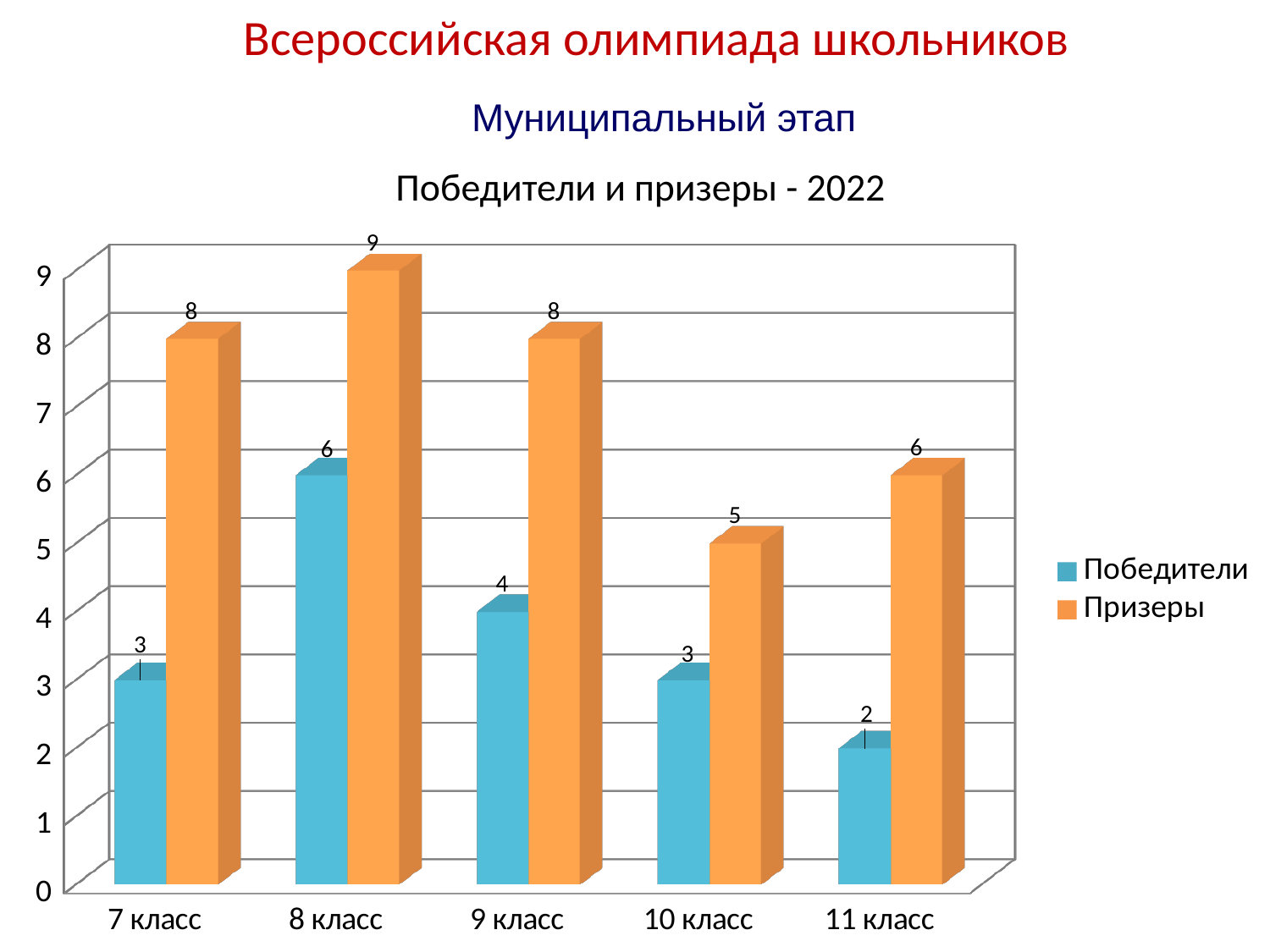
What is the value for Призеры in 10 класс? 5 Which class has the highest value for Призеры? 8 класс What is the difference between Призеры and Победители in 7 класс? 5 What is the title of the chart? Победители и призеры - 2022 Which is larger in 9 класс: Победители or Призеры? Призеры What is the value for Победители in 8 класс? 6 How many classes are shown on the x axis? 5 What colour are the bars for Призеры? Orange Which class has the lowest value for Победители? 11 класс What is the value for Победители in 11 класс? 2 What kind of chart is shown? Bar chart How many series does the legend list? 2